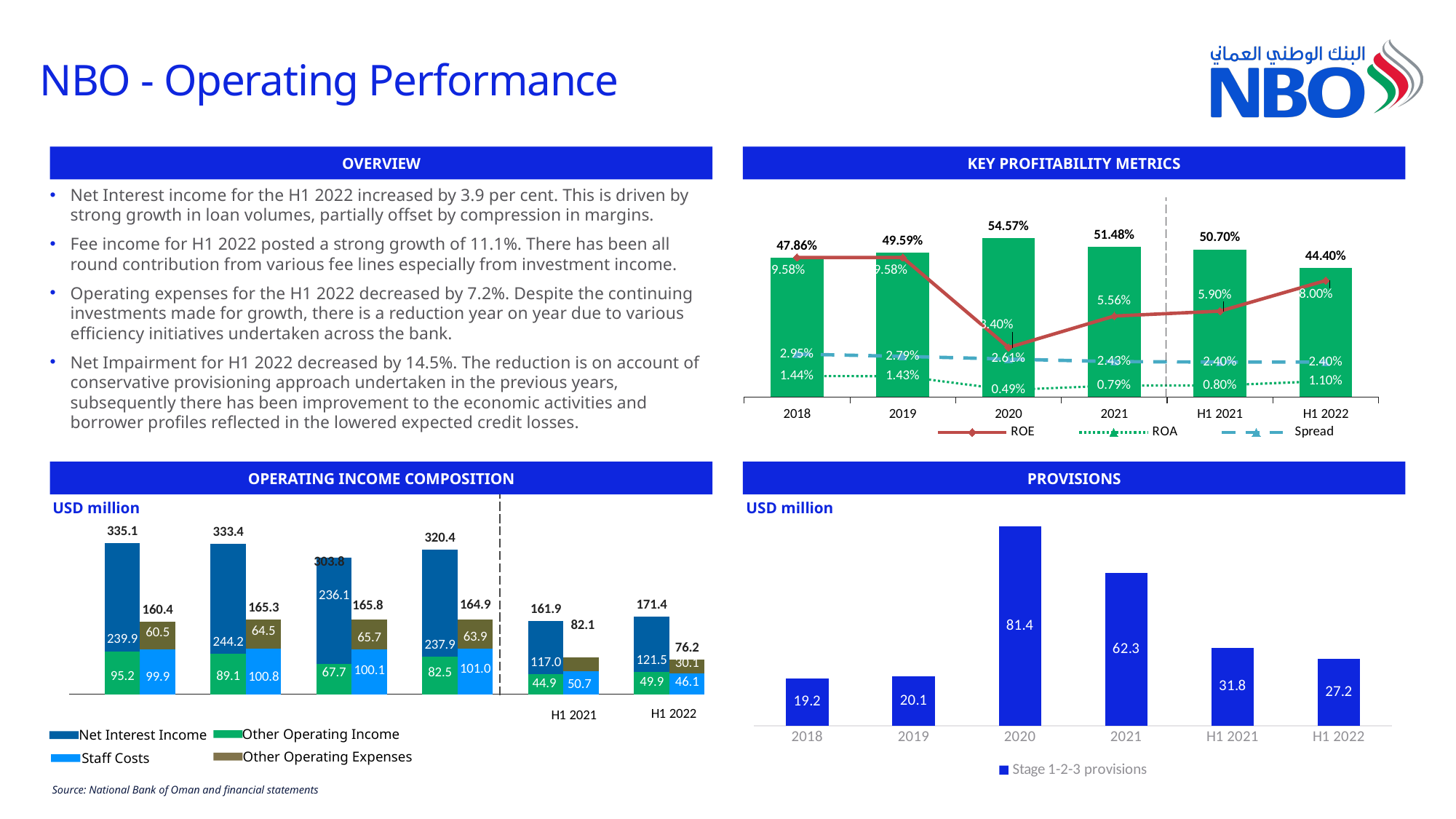
In the Provisions chart, what is the difference between the 2020 and 2021 values? 19.1 In the Operating Income Composition chart, what is the Net Interest Income value for H1 2022? 121.5 In the Key Profitability Metrics chart, what is the ROE value for 2020? 3.40% In the Operating Income Composition chart, is Staff Costs larger in H1 2021 or H1 2022? H1 2021 In the Operating Income Composition chart, what is the total operating income for H1 2021? 161.9 In the Key Profitability Metrics chart, what is the ROA value for H1 2022? 1.10% In the Provisions chart, which period has the lowest provisions? 2018 In the Provisions chart, how many periods are shown on the x axis? 6 In the Key Profitability Metrics chart, how many series does the legend list? 3 In the Provisions chart, what is the legend entry for the series? Stage 1-2-3 provisions In the Key Profitability Metrics chart, which year has the highest bar value? 2020 In the Provisions chart, what is the value for 2020? 81.4